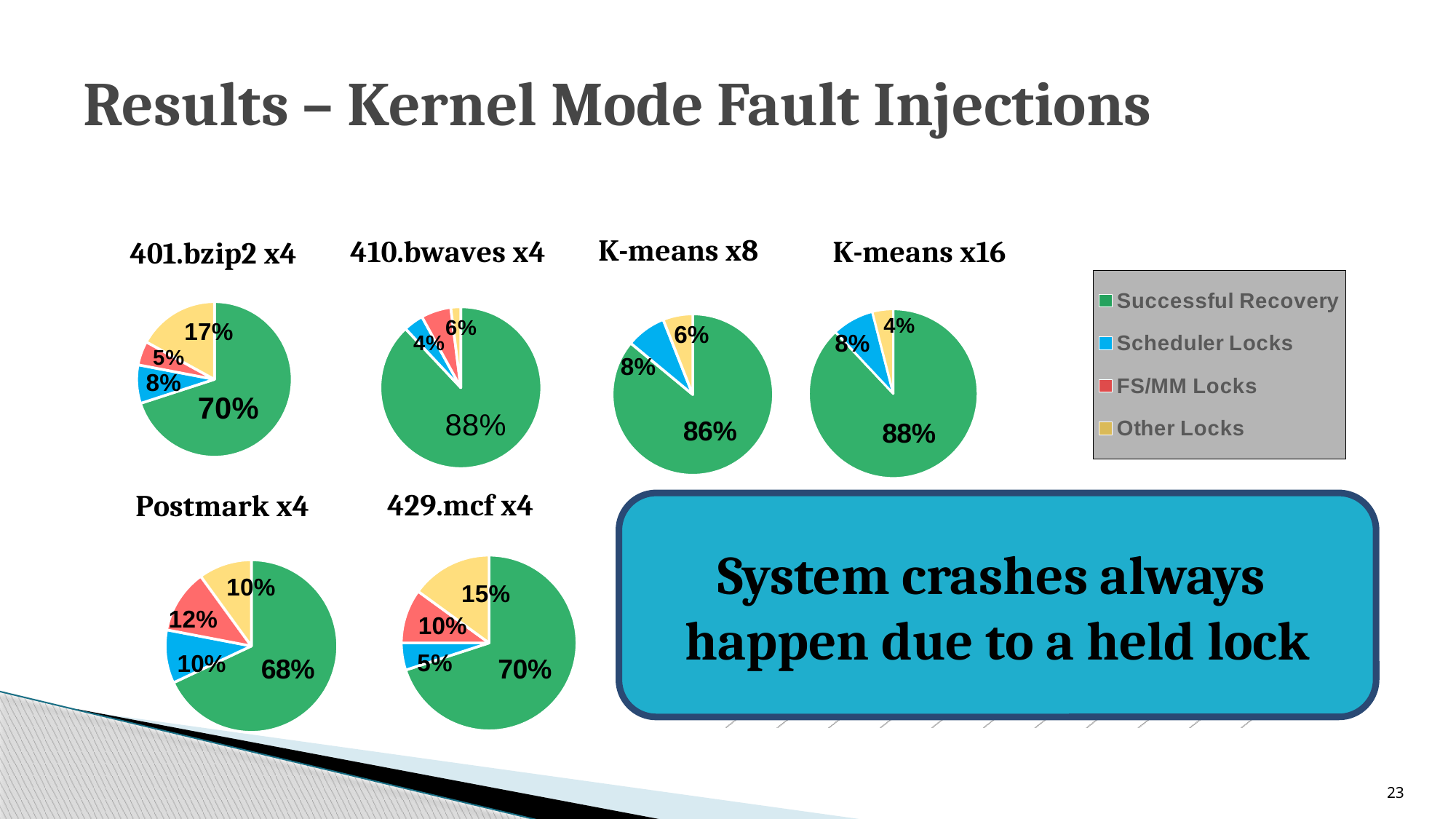
In the 429.mcf x4 pie chart, which category has the smallest slice? Scheduler Locks Which is larger: the Successful Recovery share in Postmark x4 or in K-means x8? K-means x8 In the 401.bzip2 x4 pie chart, what share is Successful Recovery? 70% In the Postmark x4 pie chart, what share is FS/MM Locks? 12% How many entries does the legend list? 4 In the Postmark x4 pie chart, which category has the largest slice? Successful Recovery In the 410.bwaves x4 pie chart, what share is Successful Recovery? 88% In the K-means x16 pie chart, what share is Other Locks? 4% In the 401.bzip2 x4 pie chart, what is the difference between the Other Locks share and the FS/MM Locks share? 12% In the 401.bzip2 x4 pie chart, what share is Other Locks? 17% In the K-means x8 pie chart, what share is Scheduler Locks? 8% In the 429.mcf x4 pie chart, what share is Scheduler Locks? 5%